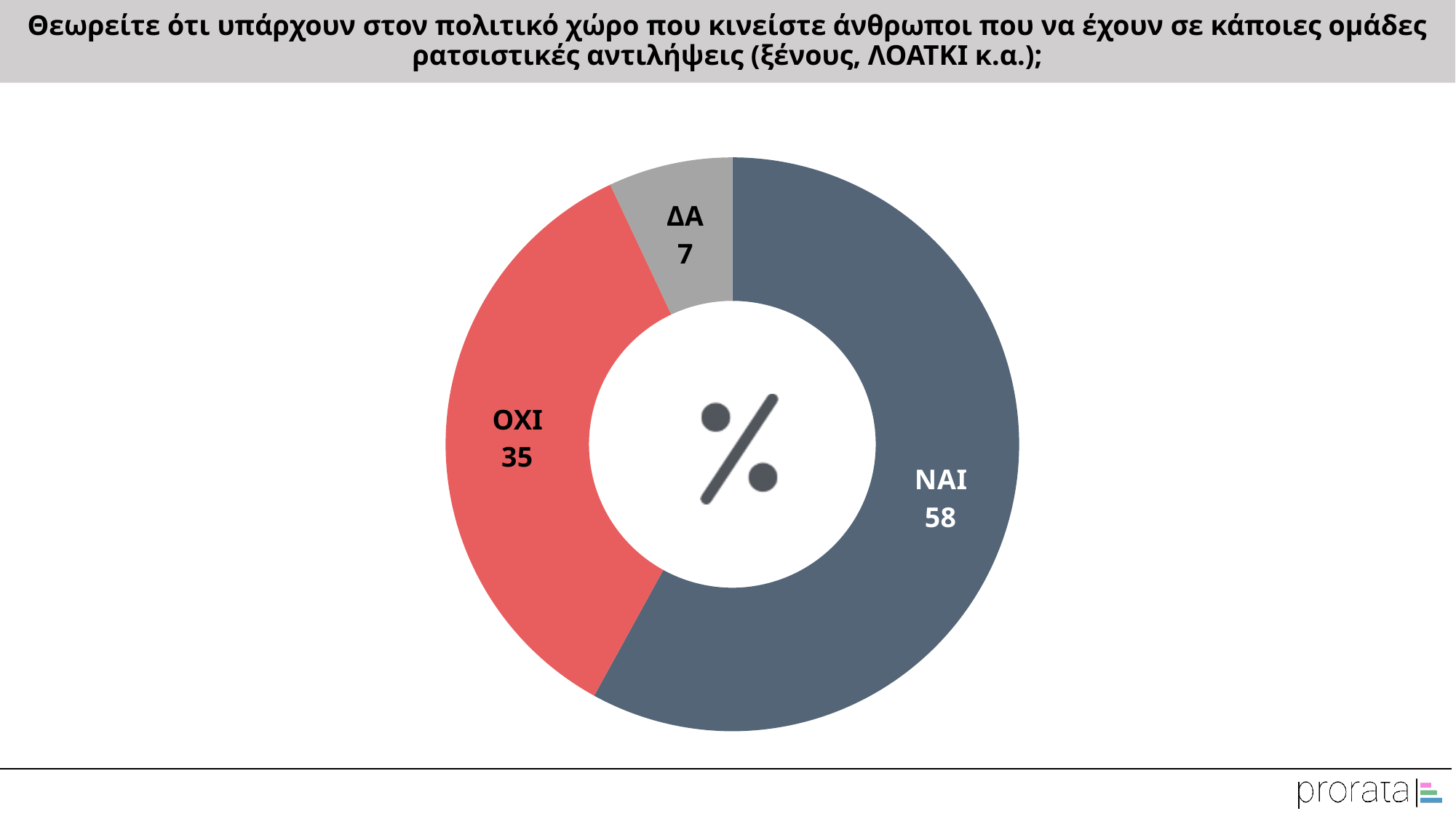
How many categories are shown in the chart? 3 What kind of chart is shown on the slide? Doughnut (pie) chart What is the difference between the values for ΟΧΙ and ΔΑ? 28 Which is larger, the value for ΟΧΙ or the value for ΔΑ? ΟΧΙ What value is shown for ΝΑΙ? 58 What colour is the ΟΧΙ segment of the chart? Red What is the total of the three values shown in the chart? 100 What is the difference between the values for ΝΑΙ and ΟΧΙ? 23 Which category has the largest share of the chart? ΝΑΙ What value is shown for ΔΑ? 7 What value is shown for ΟΧΙ? 35 Which category has the smallest share of the chart? ΔΑ